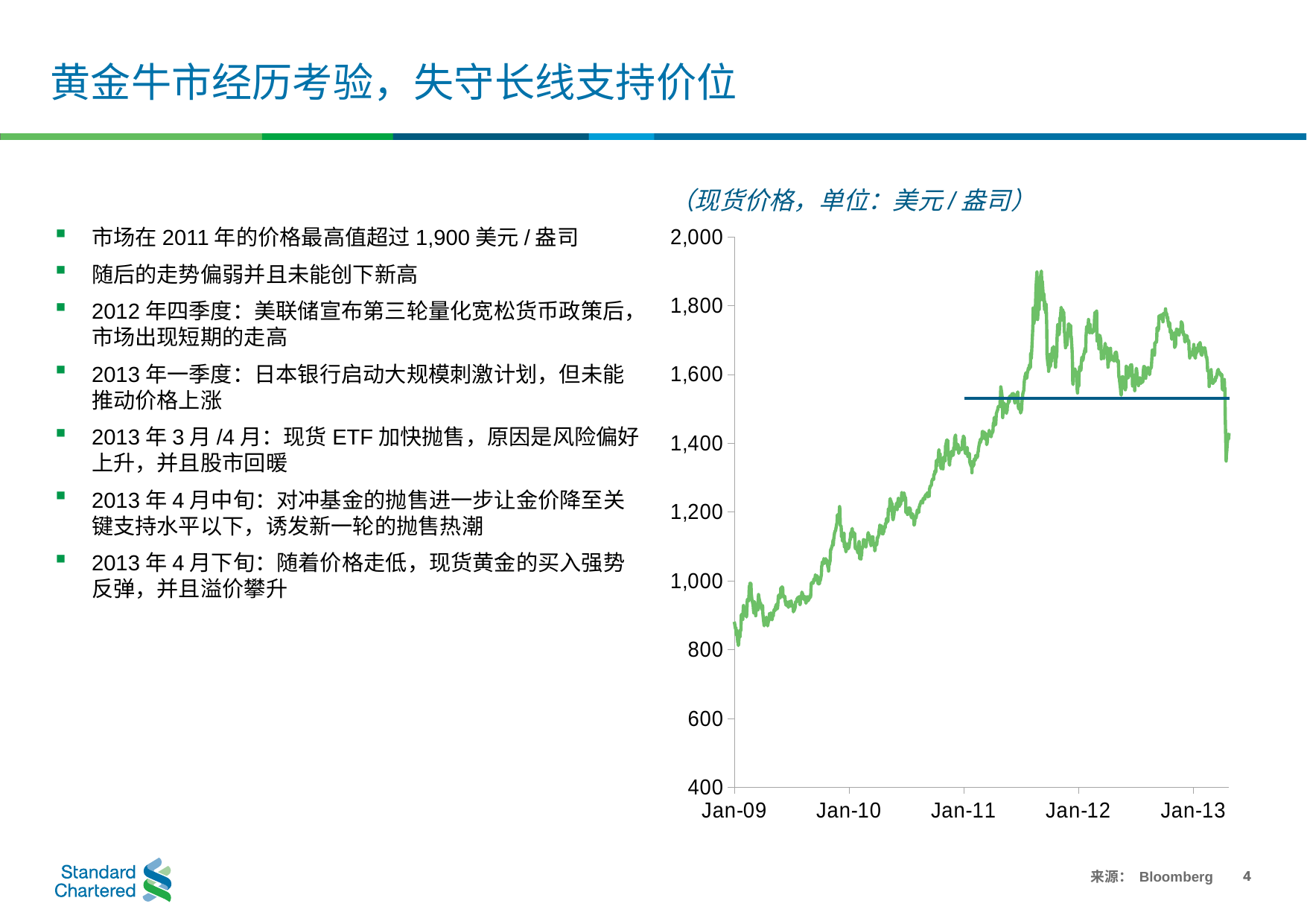
What is the highest value shown on the y axis of the chart? 2,000 Which is higher, the gold price at Jan-09 or at Jan-11? Jan-11 What is the source cited for the chart? Bloomberg How many year labels are shown on the x axis of the chart? 5 Is the gold price at Jan-10 greater or less than 1,400? less What kind of chart is shown on the slide? line chart Is the gold price at Jan-12 greater or less than 1,400? greater Is the gold price at Jan-09 greater or less than 1,000? less Does the gold price generally rise or fall from Jan-09 to Jan-11? rise What is the subtitle printed above the chart describing the plotted quantity? （现货价格，单位：美元 / 盎司） What is the lowest value shown on the y axis of the chart? 400